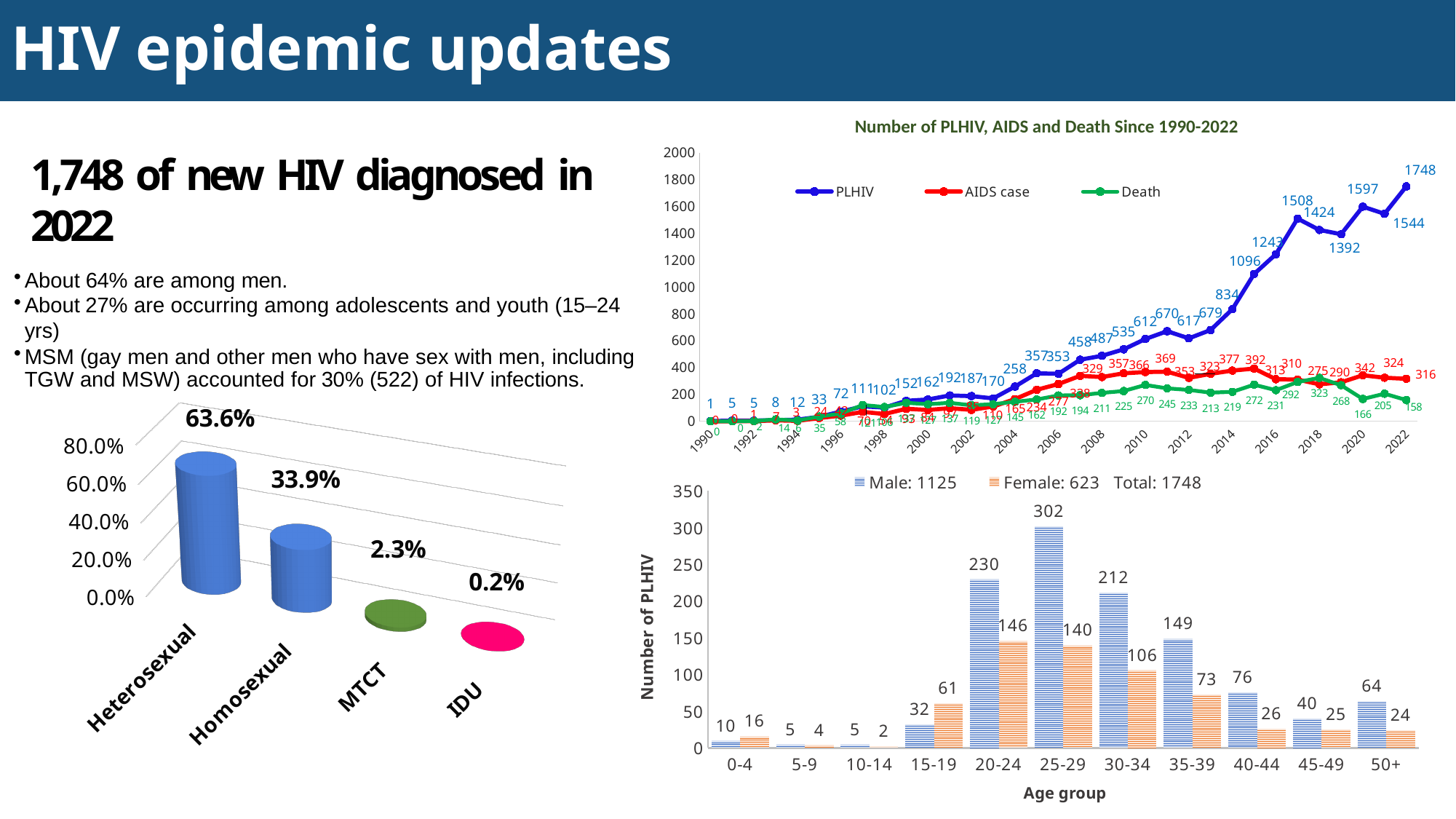
In the bottom-right bar chart by age group, how many age groups are shown on the x axis? 11 In the bottom-right bar chart by age group, what is the Male value for the 25-29 age group? 302 In the chart titled 'Number of PLHIV, AIDS and Death Since 1990-2022', how many series does the legend list? 3 In the bottom-left bar chart of transmission modes, what is the difference between the Heterosexual and Homosexual percentages? 29.7% In the bottom-right bar chart by age group, what is the difference between the Male and Female values for the 25-29 age group? 162 In the bottom-left bar chart of transmission modes, how many categories are shown? 4 In the chart titled 'Number of PLHIV, AIDS and Death Since 1990-2022', what is the PLHIV value for 2022? 1748 In the chart titled 'Number of PLHIV, AIDS and Death Since 1990-2022', does the PLHIV series generally rise or fall from 1990 to 2022? rise In the chart titled 'Number of PLHIV, AIDS and Death Since 1990-2022', what is the Death value for 2022? 158 In the bottom-right bar chart by age group, which age group has the highest Female value? 20-24 In the bottom-left bar chart of transmission modes, which category has the lowest value? IDU In the bottom-left bar chart of transmission modes, what percentage is shown for Heterosexual? 63.6%